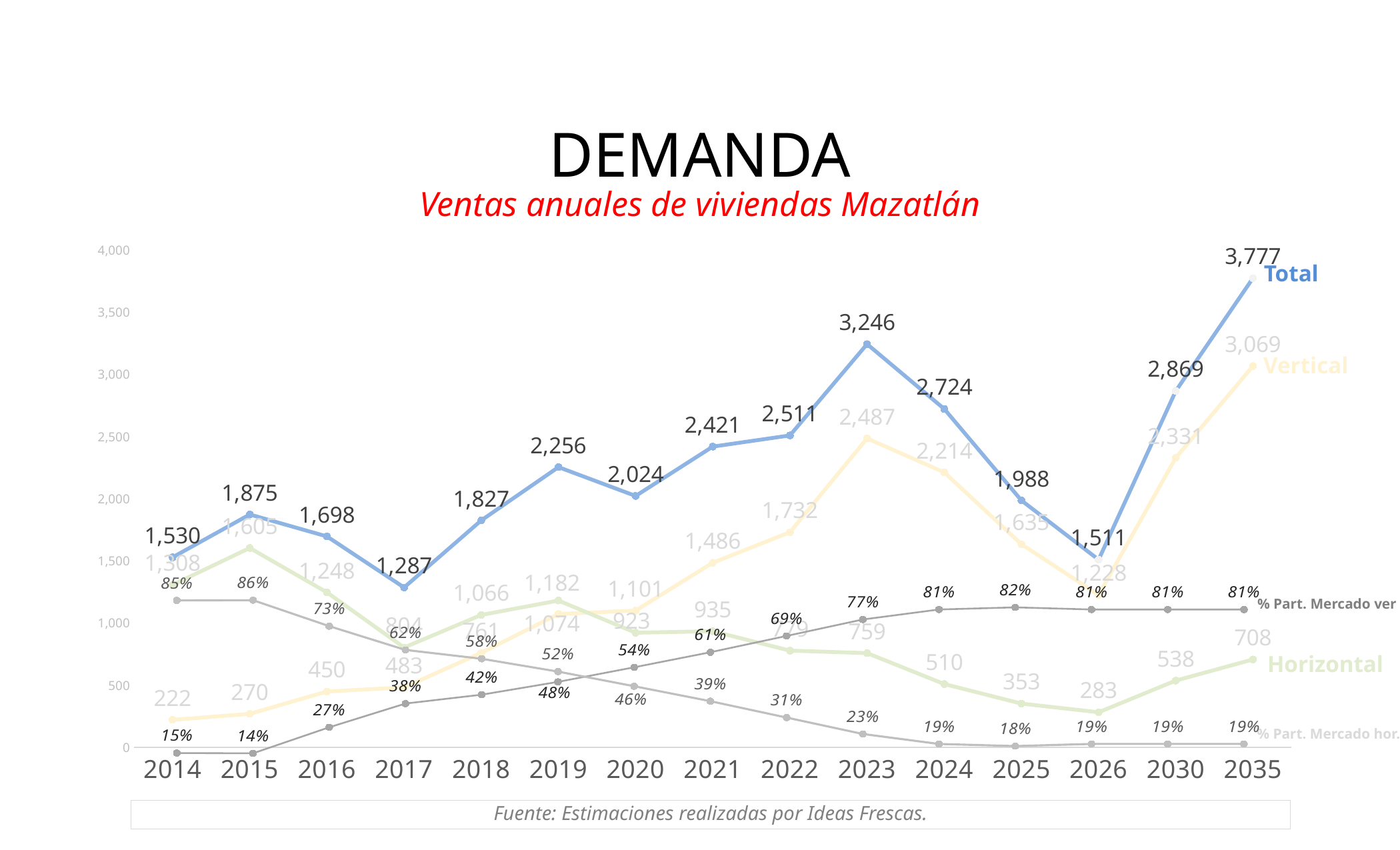
What kind of chart is shown on the slide? Line chart What is the Total value for 2023? 3,246 In which year is the Total series at its lowest? 2017 Does the Total series rise or fall from 2023 to 2026? Fall Which year has the larger Total value, 2019 or 2020? 2019 What is the Vertical value for 2035? 3,069 How many years are shown on the x axis? 15 What is the Horizontal value for 2015? 1,605 What is the value of % Part. Mercado ver. for 2035? 81% What is the red subtitle of the chart? Ventas anuales de viviendas Mazatlán In which year is the Total series at its highest? 2035 What is the difference between the Total values for 2035 and 2030? 908